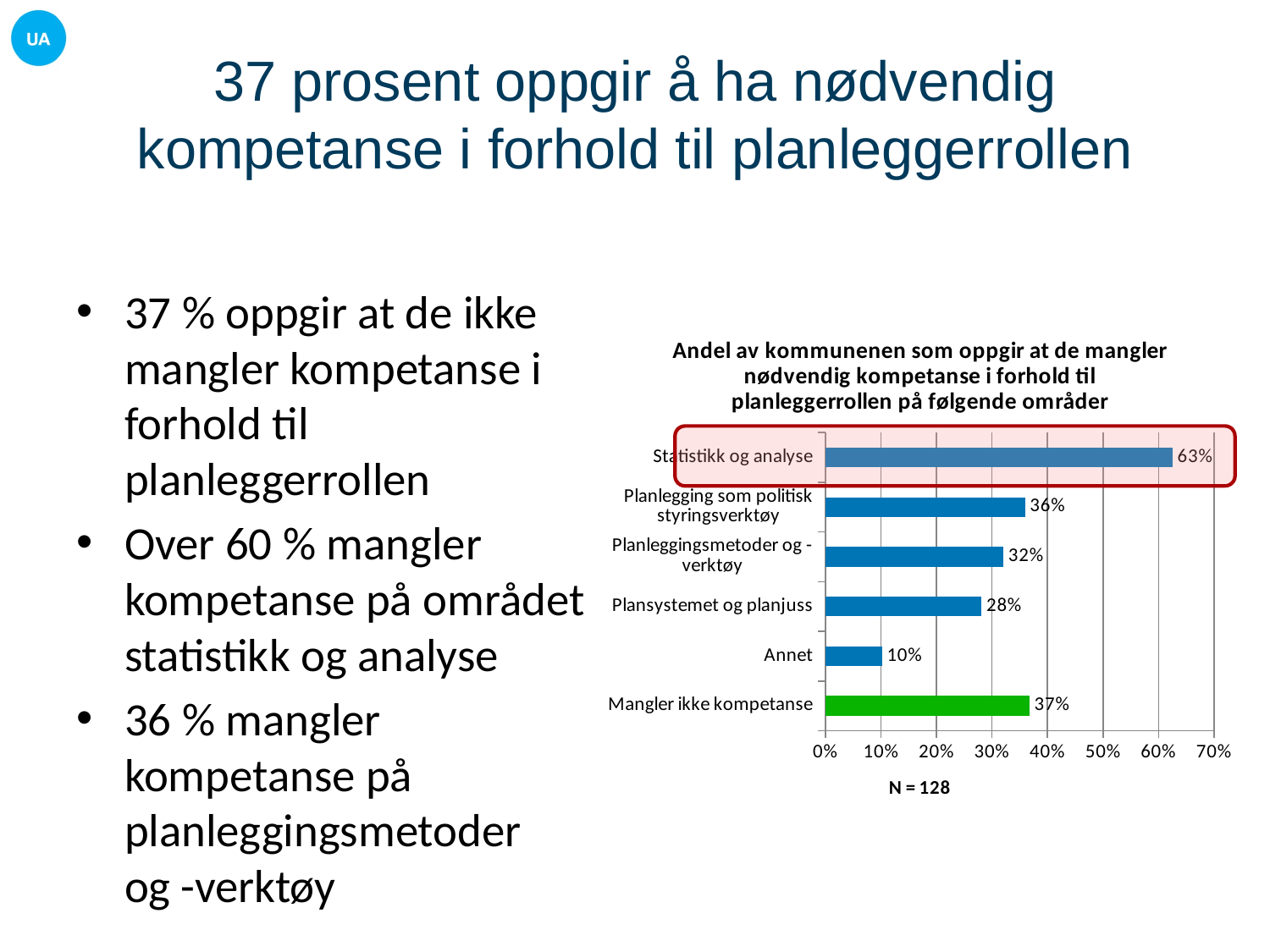
Which is larger, the value for Planleggingsmetoder og -verktøy or the value for Plansystemet og planjuss? Planleggingsmetoder og -verktøy What is the difference between the values for Statistikk og analyse and Planlegging som politisk styringsverktøy? 27% Which category has the lowest value? Annet What kind of chart is shown on the slide? Bar chart Is the value for Statistikk og analyse greater or less than 60%? greater What is the value for Annet? 10% What is the value for Mangler ikke kompetanse? 37% What sample size (N) is stated below the chart? N = 128 How many categories are shown in the chart? 6 What is the value for Plansystemet og planjuss? 28% Which category has the highest value? Statistikk og analyse What is the value for Statistikk og analyse? 63%